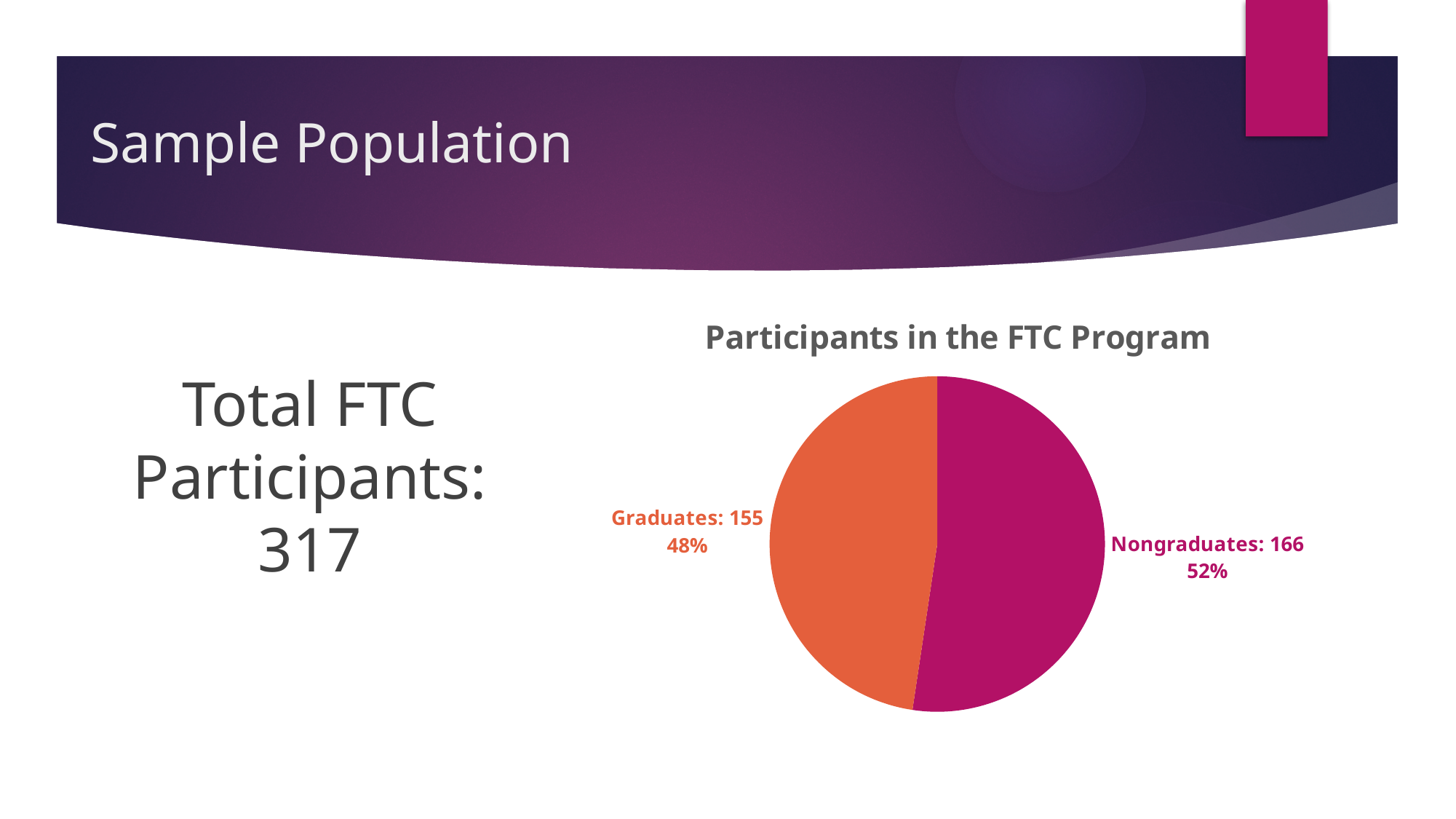
Is the number of Graduates greater or less than the number of Nongraduates? less How many slices does the pie chart have? 2 What colour is the Nongraduates slice? magenta How many participants are Nongraduates according to the chart? 166 What share of the pie do Nongraduates represent? 52% What is the title of the chart? Participants in the FTC Program Which category has the larger slice of the pie? Nongraduates What kind of chart is shown on the slide? pie chart How many participants are Graduates according to the chart? 155 What share of the pie do Graduates represent? 48% What is the difference between the number of Nongraduates and Graduates? 11 Which category has the smaller slice of the pie? Graduates